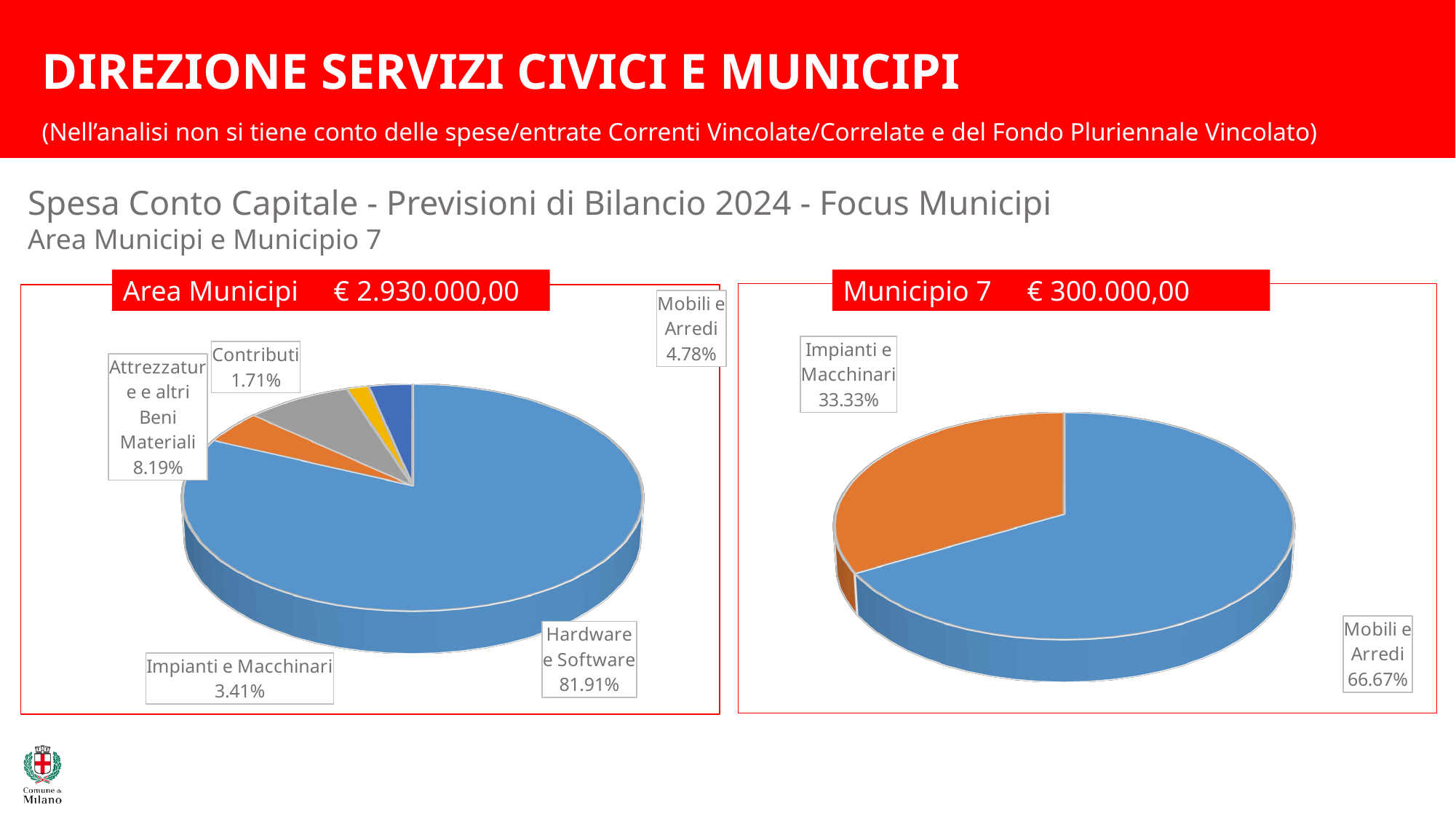
What total amount is shown in the title box of the Municipio 7 chart? € 300.000,00 What kind of chart is the Municipio 7 chart? Pie chart In the Area Municipi chart, what is the difference in percentage points between Mobili e Arredi and Impianti e Macchinari? 1.37 In the Area Municipi chart, which is larger: Mobili e Arredi or Impianti e Macchinari? Mobili e Arredi In the Area Municipi chart, what share does Hardware e Software have? 81.91% In the Area Municipi chart, how many slices does the pie have? 5 In the Area Municipi chart, which category has the smallest slice? Contributi In the Area Municipi chart, which category has the largest slice? Hardware e Software In the Area Municipi chart, what share does Contributi have? 1.71% In the Area Municipi chart, what share does Attrezzature e altri Beni Materiali have? 8.19% In the Municipio 7 chart, what share does Impianti e Macchinari have? 33.33% In the Municipio 7 chart, which category has the largest slice? Mobili e Arredi